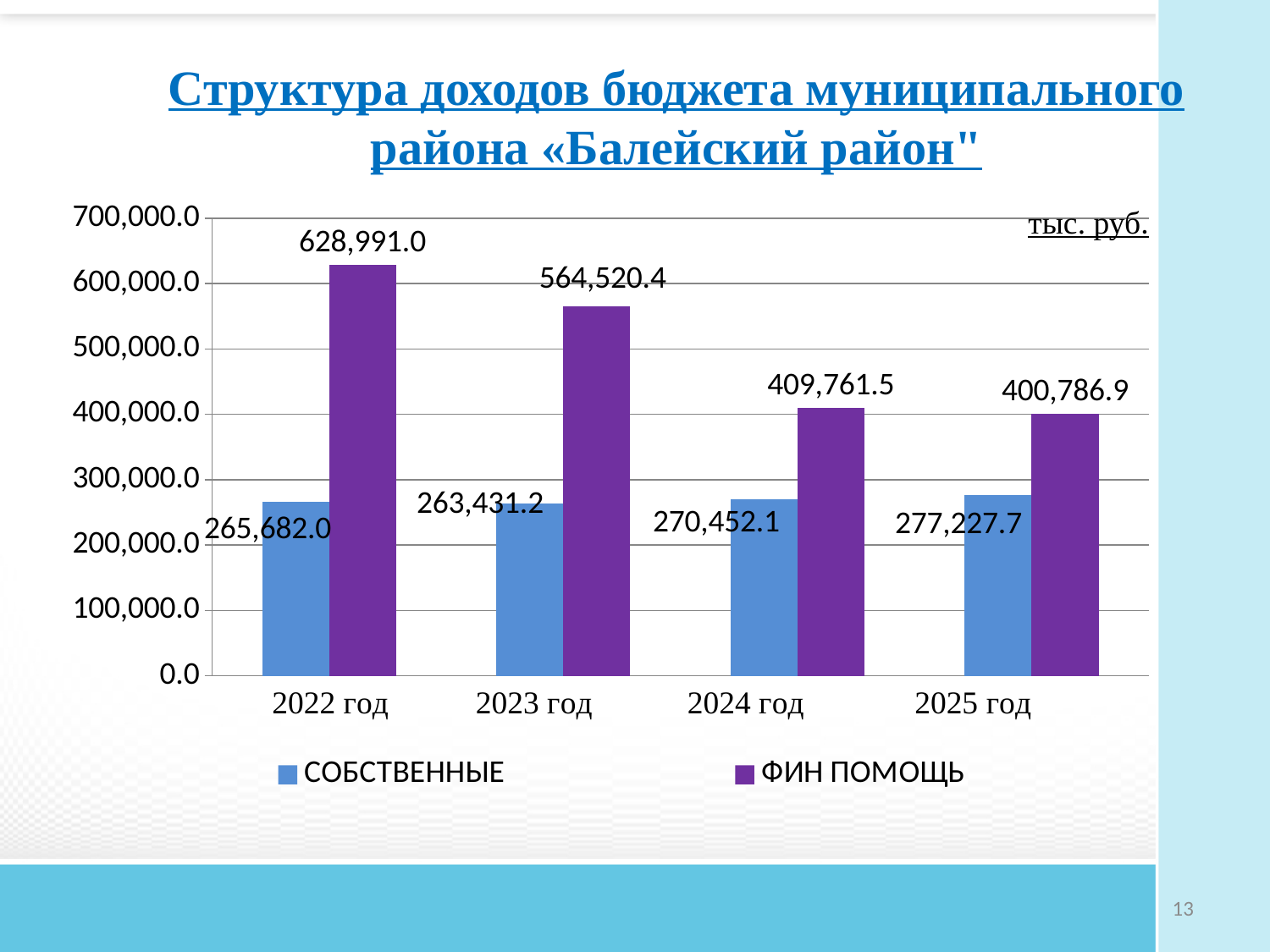
What is the value of ФИН ПОМОЩЬ for 2024 год? 409,761.5 How many years are shown on the x axis? 4 Which is larger in 2023 год: СОБСТВЕННЫЕ or ФИН ПОМОЩЬ? ФИН ПОМОЩЬ What is the difference between ФИН ПОМОЩЬ and СОБСТВЕННЫЕ in 2025 год? 123,559.2 In which year is СОБСТВЕННЫЕ lowest? 2023 год What is the value of ФИН ПОМОЩЬ for 2022 год? 628,991.0 What kind of chart is shown on the slide? Bar chart How many series does the legend list? 2 In which year is ФИН ПОМОЩЬ highest? 2022 год What is the difference between ФИН ПОМОЩЬ and СОБСТВЕННЫЕ in 2022 год? 363,309.0 Does ФИН ПОМОЩЬ rise or fall from 2022 год to 2025 год? Fall What is the value of СОБСТВЕННЫЕ for 2025 год? 277,227.7